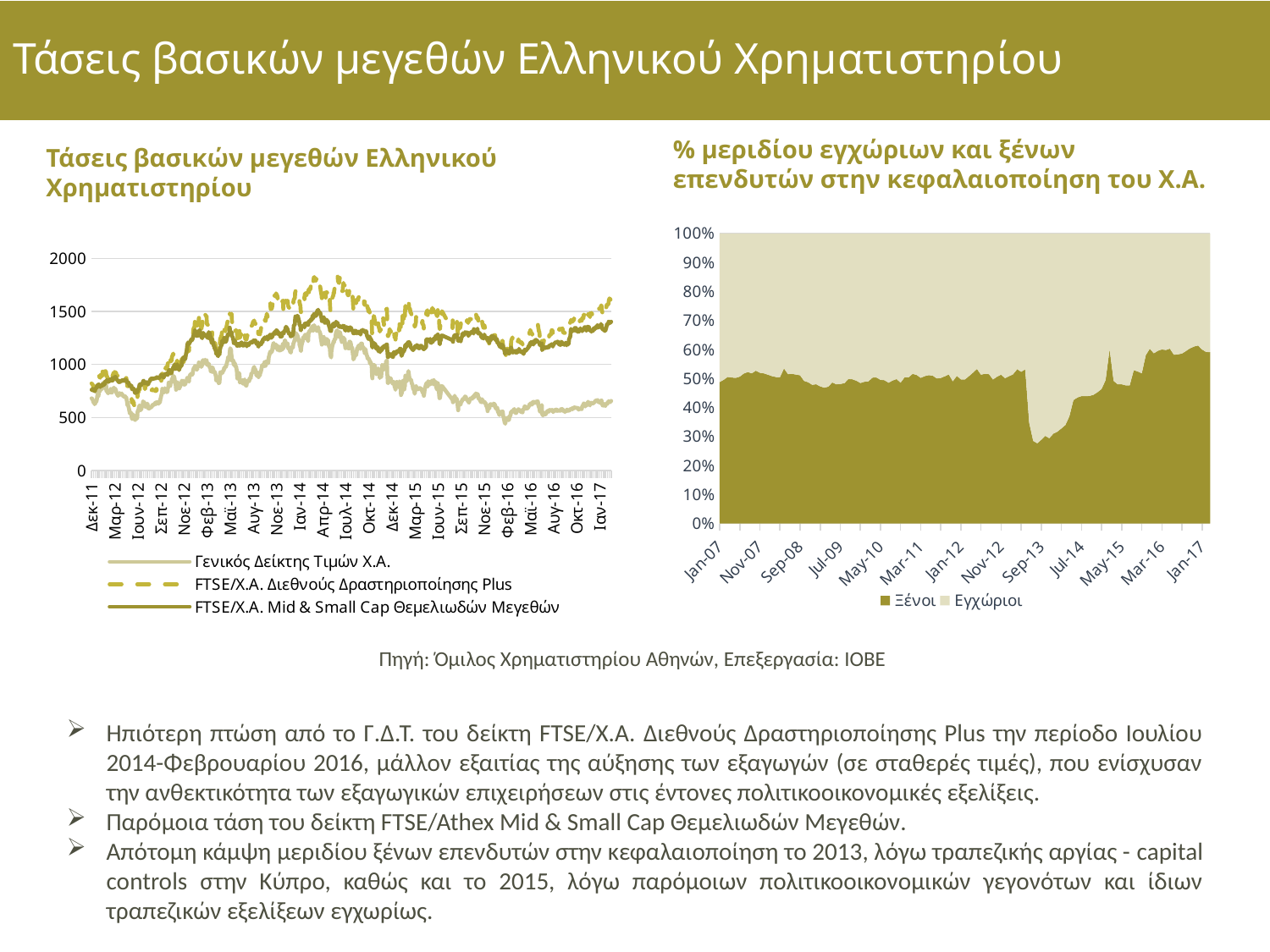
In the left chart 'Τάσεις βασικών μεγεθών Ελληνικού Χρηματιστηρίου', is the value of FTSE/Χ.Α. Διεθνούς Δραστηριοποίησης Plus at Ιαν-17 greater or less than 1500? greater In the left chart 'Τάσεις βασικών μεγεθών Ελληνικού Χρηματιστηρίου', which series has the higher value at Ιαν-17: Γενικός Δείκτης Τιμών Χ.Α. or FTSE/Χ.Α. Mid & Small Cap Θεμελιωδών Μεγεθών? FTSE/Χ.Α. Mid & Small Cap Θεμελιωδών Μεγεθών In the right chart '% μεριδίου εγχώριων και ξένων επενδυτών στην κεφαλαιοποίηση του Χ.Α.', is the share of Ξένοι at Jan-17 greater or less than 50%? greater What kind of chart is the left chart titled 'Τάσεις βασικών μεγεθών Ελληνικού Χρηματιστηρίου'? Line chart In the left chart 'Τάσεις βασικών μεγεθών Ελληνικού Χρηματιστηρίου', is the value of Γενικός Δείκτης Τιμών Χ.Α. at Ιαν-17 greater or less than 1000? less In the left chart 'Τάσεις βασικών μεγεθών Ελληνικού Χρηματιστηρίου', which series is drawn with a dashed line? FTSE/Χ.Α. Διεθνούς Δραστηριοποίησης Plus In the right chart '% μεριδίου εγχώριων και ξένων επενδυτών στην κεφαλαιοποίηση του Χ.Α.', which group has the larger share at Jan-17: Ξένοι or Εγχώριοι? Ξένοι How many series does the legend of the left chart 'Τάσεις βασικών μεγεθών Ελληνικού Χρηματιστηρίου' list? 3 What kind of chart is the right chart titled '% μεριδίου εγχώριων και ξένων επενδυτών στην κεφαλαιοποίηση του Χ.Α.'? Stacked area chart How many series does the legend of the right chart '% μεριδίου εγχώριων και ξένων επενδυτών στην κεφαλαιοποίηση του Χ.Α.' list? 2